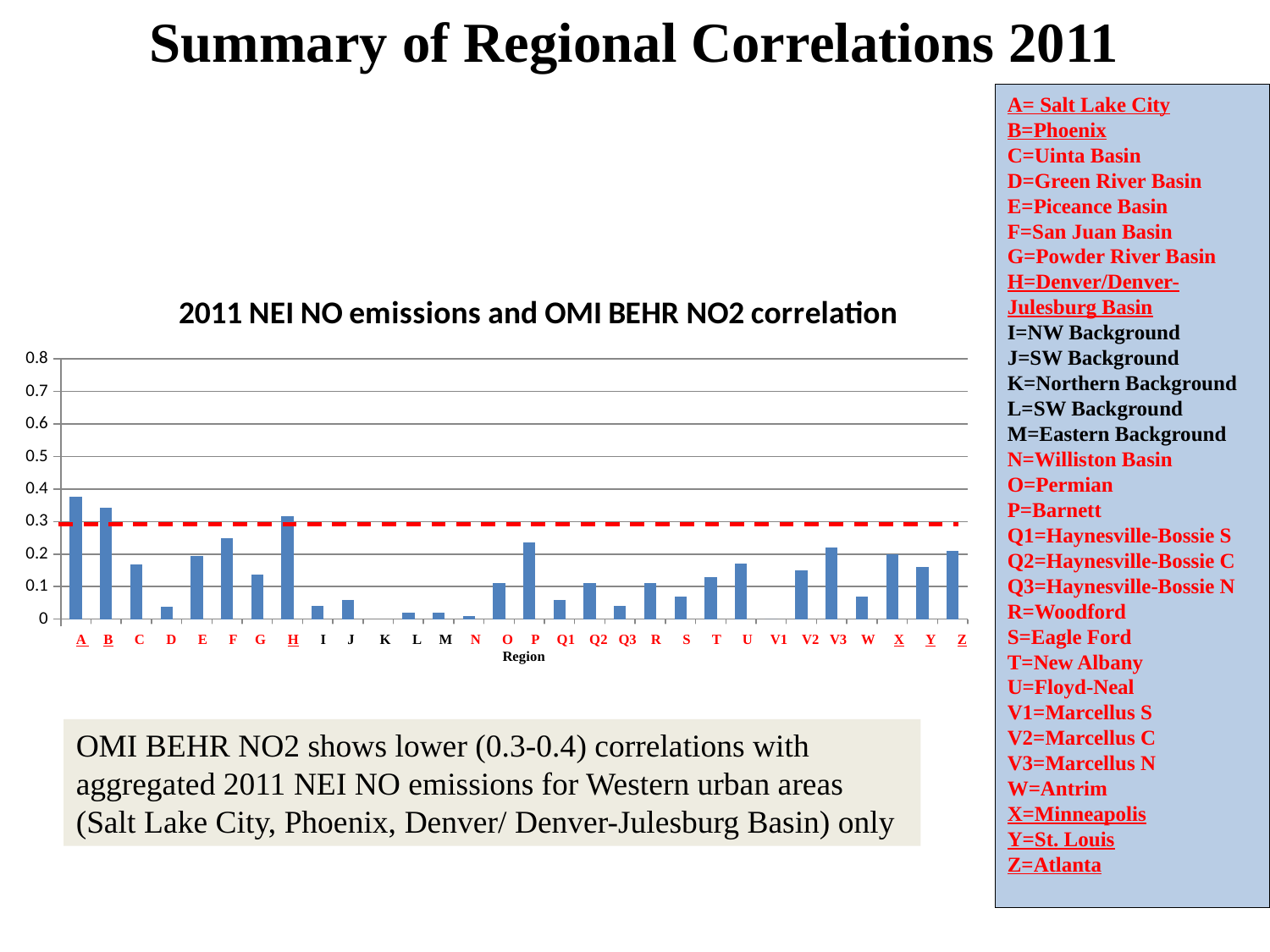
Is the value for P greater or less than 0.3? less Which is larger, the value for E or the value for D? E Is the value for A greater or less than 0.3? greater What is the label of the x axis of the chart? Region What kind of chart is shown on the slide? bar chart Is the value for F greater or less than 0.2? greater What is the title of the chart? 2011 NEI NO emissions and OMI BEHR NO2 correlation Which is larger, the value for P or the value for Q1? P How many regions (categories) are plotted along the x axis? 30 Which region has the highest correlation value? A Which region has the lowest correlation value? K